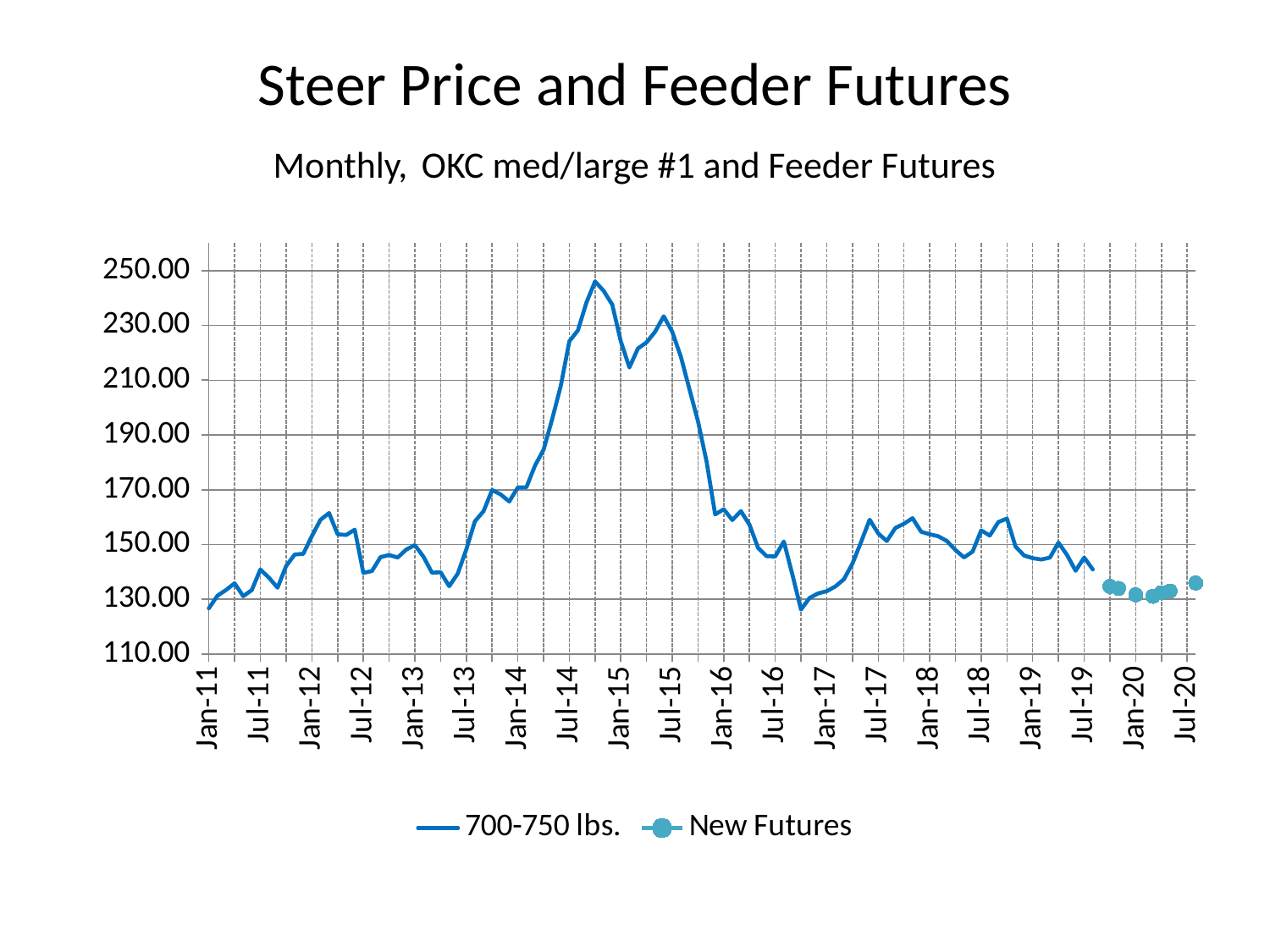
Are the New Futures points plotted greater or less than 150? less In which year does the 700-750 lbs. series reach its highest value? 2014 What is the title of the chart? Steer Price and Feeder Futures Which is larger for the 700-750 lbs. series, the value at Jan-16 or the value at Jan-17? Jan-16 What kind of chart is shown on the slide? line chart Is the value of the 700-750 lbs. series at Jan-17 greater or less than 150? less Is the value of the 700-750 lbs. series at Jul-15 greater or less than 210? greater How many series does the legend list? 2 What are the two series named in the legend? 700-750 lbs. and New Futures Which is larger for the 700-750 lbs. series, the value at Jul-15 or the value at Jul-16? Jul-15 Does the 700-750 lbs. series rise or fall between Jul-15 and Jan-17? fall